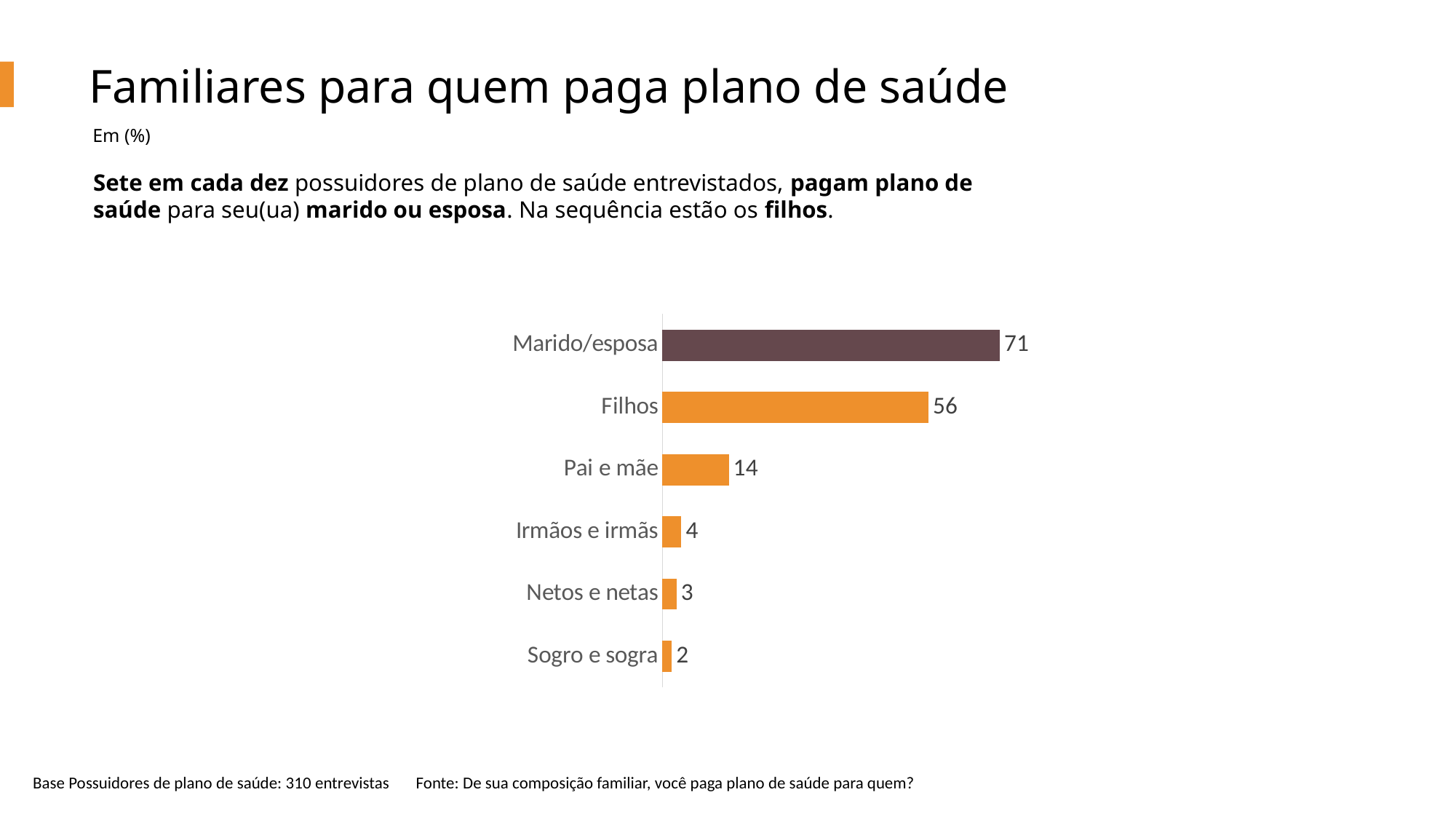
Which bar is shown in a different colour from the others? Marido/esposa What is the value for Netos e netas? 3 Which is larger, the value for Irmãos e irmãs or the value for Netos e netas? Irmãos e irmãs What is the value for Marido/esposa? 71 What is the value for Pai e mãe? 14 Which category has the highest value? Marido/esposa Which category has the lowest value? Sogro e sogra How many categories are shown in the chart? 6 What kind of chart is shown on the slide? Bar chart What is the difference between the values for Marido/esposa and Filhos? 15 What is the value for Filhos? 56 What is the difference between the values for Filhos and Pai e mãe? 42